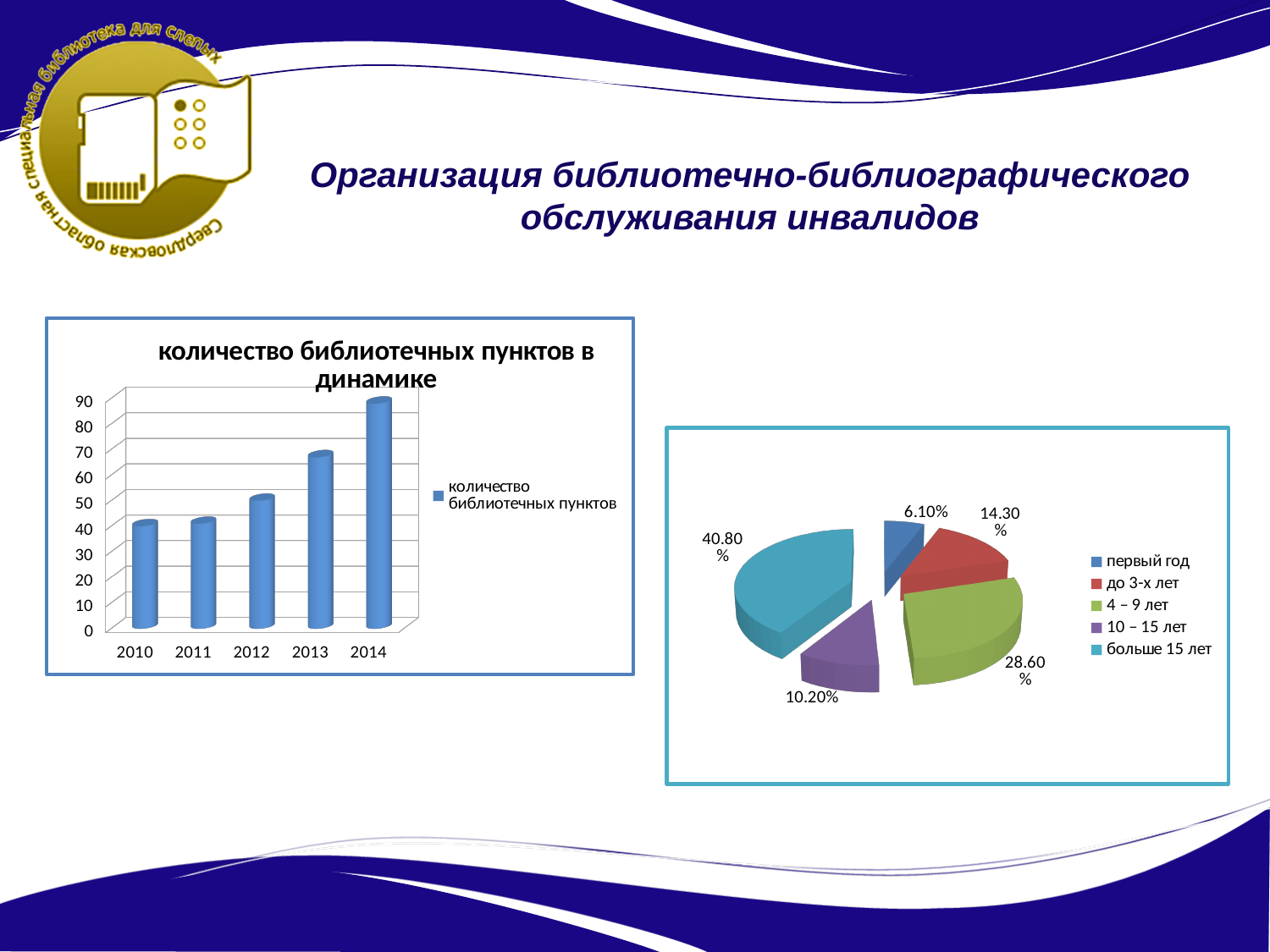
In the right pie chart, how many categories does the legend list? 5 In the left bar chart, is the value for 2013 greater or less than 60? greater In the left bar chart, how many years are shown on the x axis? 5 What kind of chart is the right chart on the slide? pie chart In the right pie chart, what share does "первый год" have? 6.10% In the right pie chart, what share does "больше 15 лет" have? 40.80% In the left bar chart, do the values generally rise or fall from 2010 to 2014? rise In the left bar chart, which is larger: the value for 2013 or the value for 2012? 2013 What kind of chart is the left chart titled "количество библиотечных пунктов в динамике"? bar chart In the left bar chart, which year has the highest number of library points? 2014 In the left bar chart, is the value for 2014 greater or less than 80? greater In the left bar chart, is the value for 2010 greater or less than 50? less